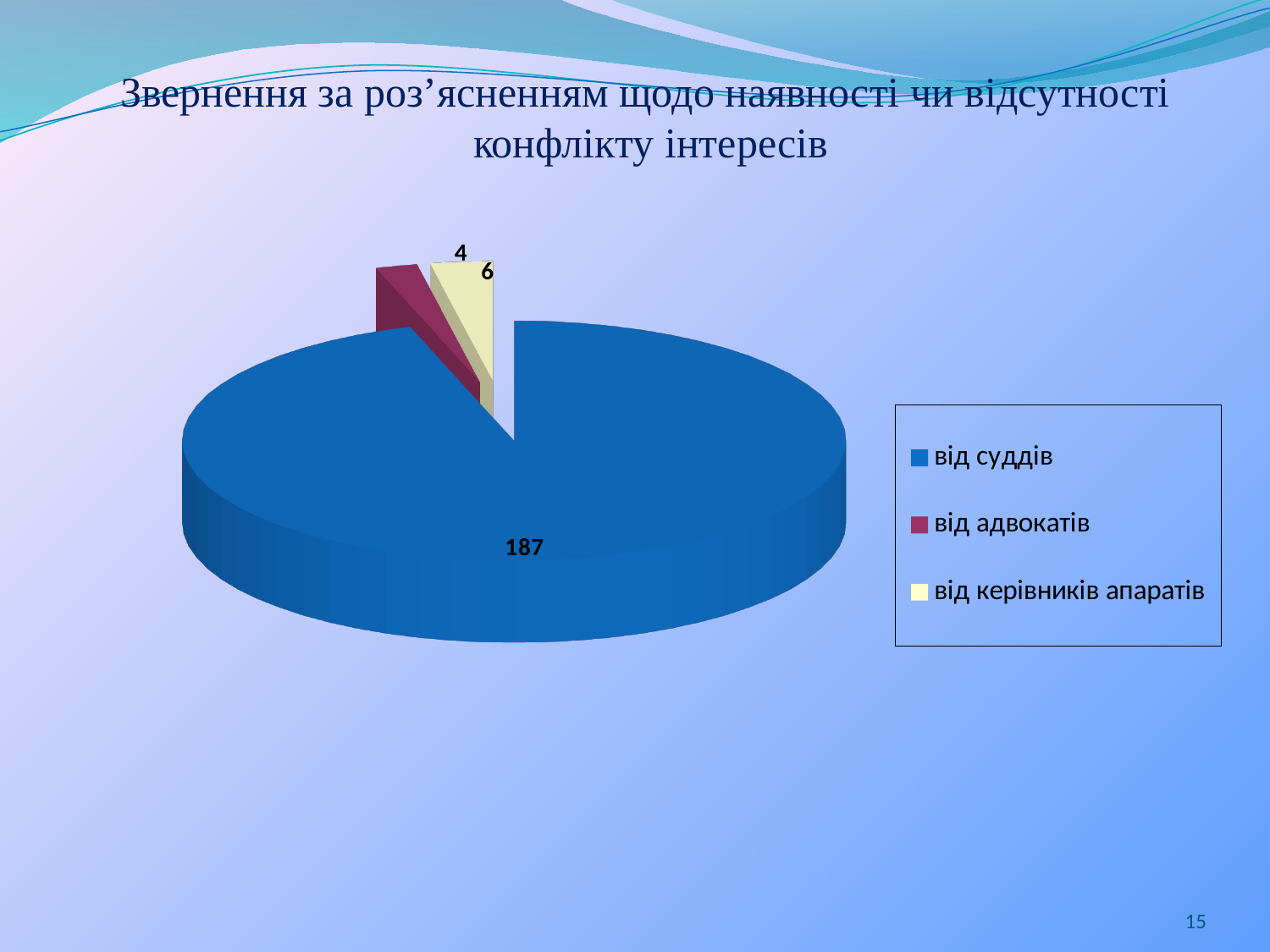
How many categories does the pie chart have? 3 Which is larger, the value for "від керівників апаратів" or the value for "від адвокатів"? від керівників апаратів What is the value for "від керівників апаратів"? 6 What is the difference between the values for "від керівників апаратів" and "від адвокатів"? 2 What is the total of all slices in the pie chart? 197 What is the difference between the values for "від суддів" and "від керівників апаратів"? 181 What is the value for "від адвокатів"? 4 What colour is the slice for "від суддів"? blue What is the value for "від суддів"? 187 Which category has the smallest slice of the pie? від адвокатів What type of chart is shown on the slide? pie chart Which category has the largest slice of the pie? від суддів